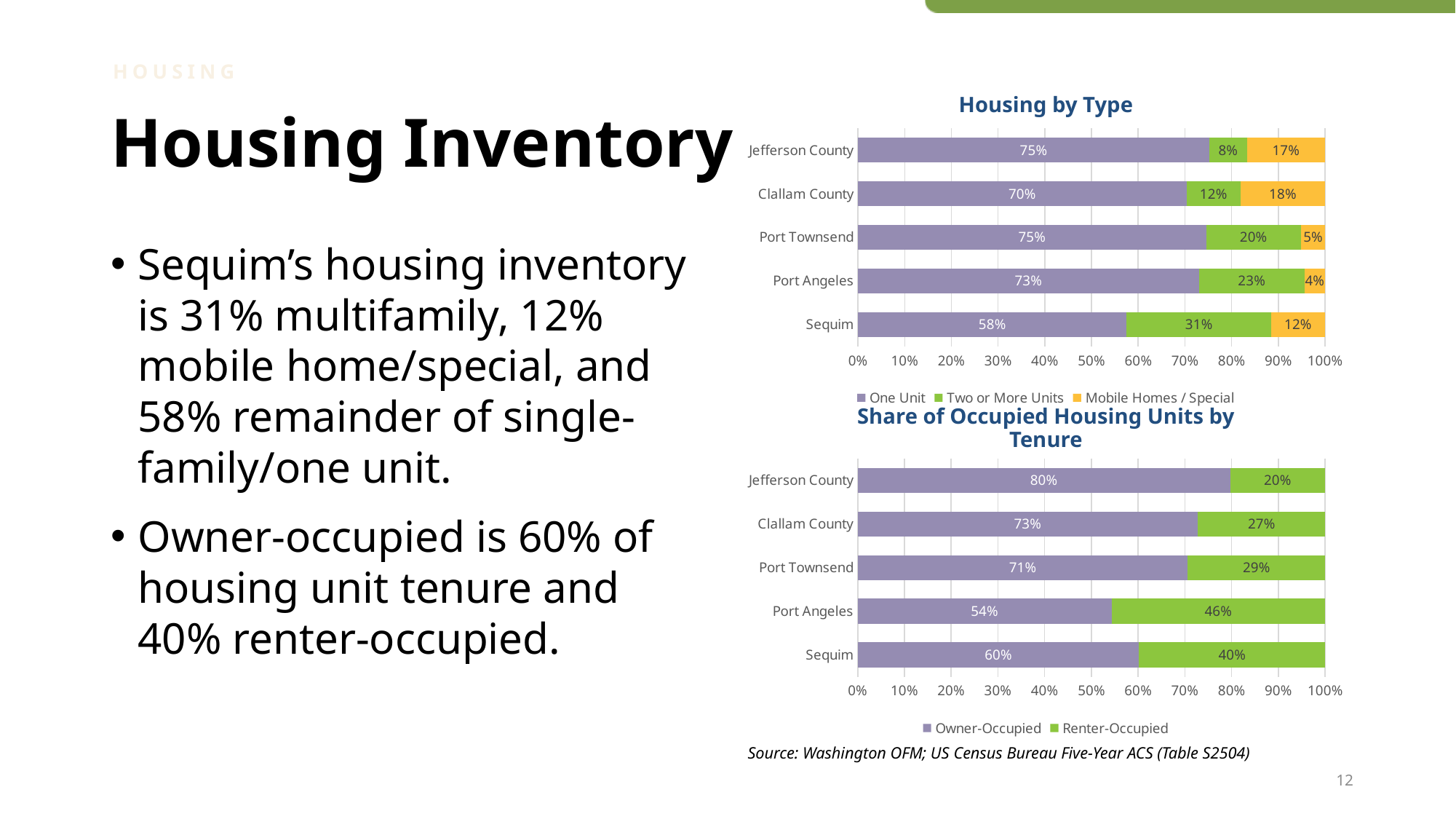
In the 'Housing by Type' chart, how many series does the legend list? 3 In the 'Housing by Type' chart, which category has the highest Mobile Homes / Special value? Clallam County In the 'Share of Occupied Housing Units by Tenure' chart, is the Owner-Occupied value larger for Clallam County or Sequim? Clallam County How many categories are shown in the 'Share of Occupied Housing Units by Tenure' chart? 5 In the 'Housing by Type' chart, what is the One Unit value for Sequim? 58% In the 'Share of Occupied Housing Units by Tenure' chart, what is the Renter-Occupied value for Port Townsend? 29% In the 'Housing by Type' chart, what is the Two or More Units value for Port Angeles? 23% In the 'Housing by Type' chart, what is the difference between the Two or More Units values for Sequim and Jefferson County? 23% In the 'Share of Occupied Housing Units by Tenure' chart, which category has the highest Renter-Occupied value? Port Angeles In the 'Share of Occupied Housing Units by Tenure' chart, what is the difference between the Owner-Occupied values for Jefferson County and Port Angeles? 26% What kind of chart is the 'Housing by Type' chart? Stacked bar chart In the 'Housing by Type' chart, which category has the lowest One Unit value? Sequim